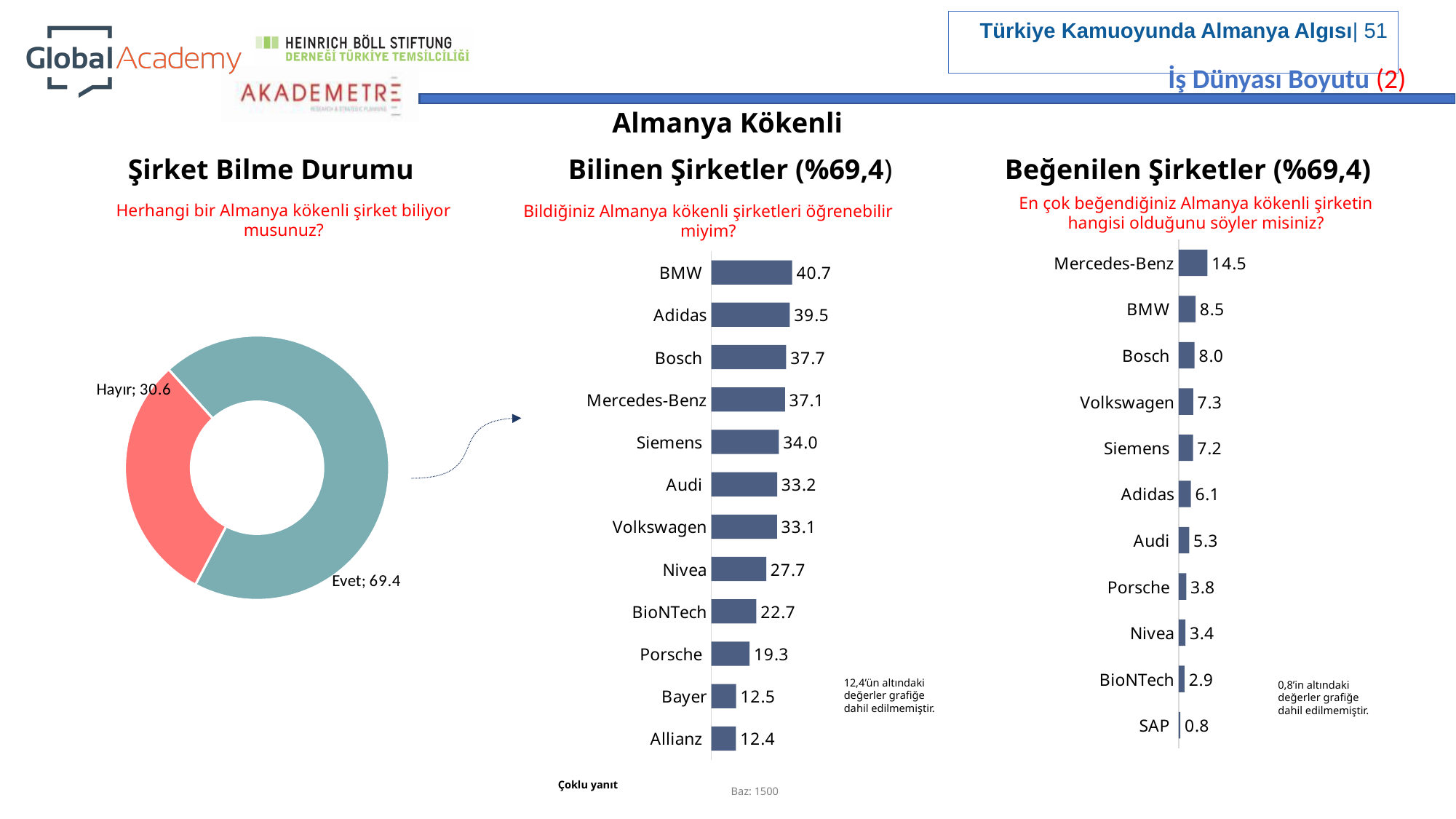
In the "Bilinen Şirketler (%69,4)" chart, what is the value for Siemens? 34.0 In the "Beğenilen Şirketler (%69,4)" chart, what is the value for Mercedes-Benz? 14.5 In the "Şirket Bilme Durumu" chart, what is the value for Evet? 69.4 In the "Bilinen Şirketler (%69,4)" chart, what is the difference between BMW and Adidas? 1.2 In the "Bilinen Şirketler (%69,4)" chart, which company has the highest value? BMW In the "Bilinen Şirketler (%69,4)" chart, which company has the lowest value? Allianz What kind of chart is the "Şirket Bilme Durumu" chart? Donut (pie) chart In the "Bilinen Şirketler (%69,4)" chart, how many companies are listed? 12 What kind of chart is the "Beğenilen Şirketler (%69,4)" chart? Bar chart In the "Şirket Bilme Durumu" chart, what is the value for Hayır? 30.6 In the "Beğenilen Şirketler (%69,4)" chart, which company has the lowest value? SAP In the "Beğenilen Şirketler (%69,4)" chart, which is larger, Bosch or Volkswagen? Bosch